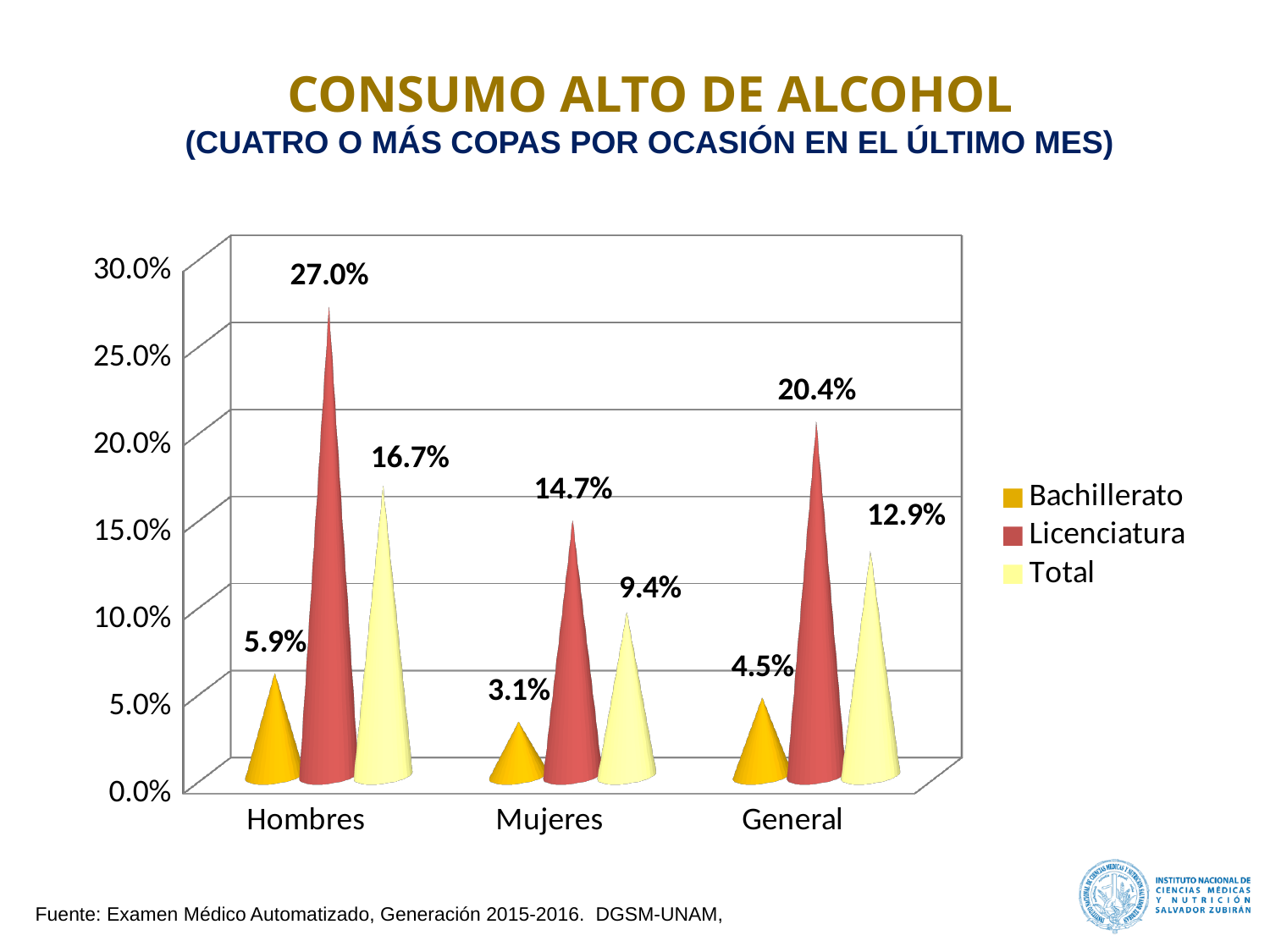
What kind of chart is shown on the slide? Bar chart What is the Licenciatura value for Hombres? 27.0% Which category has the lowest Bachillerato value? Mujeres Which category has the highest Licenciatura value? Hombres Is the Licenciatura value for General greater or less than 15.0%? greater Which series is shown in red in the legend? Licenciatura How many series does the legend list? 3 What is the Bachillerato value for Mujeres? 3.1% What is the Total value for General? 12.9% What is the difference between the Licenciatura values for Hombres and Mujeres? 12.3% Which is larger, the Total value for Hombres or the Total value for Mujeres? Hombres How many categories are shown on the x axis? 3